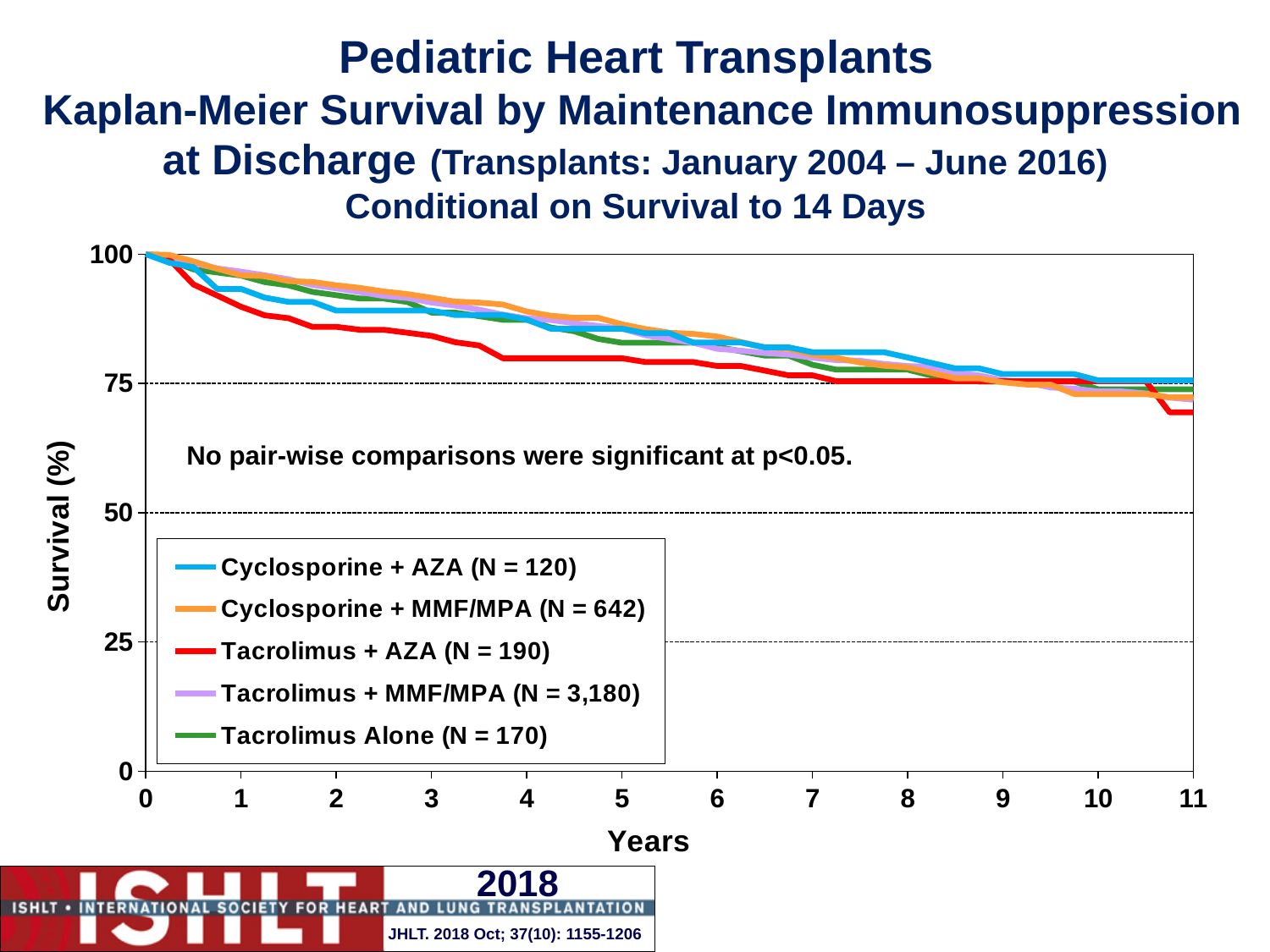
Do the survival curves rise or fall as years increase along the x axis? Fall What is the label of the x axis? Years What is the label of the y axis? Survival (%) Which series has the lowest survival at 1 year? Tacrolimus + AZA Is the survival for Cyclosporine + MMF/MPA at 2 years greater or less than 75? greater Is the survival for Tacrolimus + AZA at 4 years greater or less than 75? greater What kind of chart is shown on the slide? Line chart At 3 years, which has higher survival: Cyclosporine + MMF/MPA or Tacrolimus + AZA? Cyclosporine + MMF/MPA Is the survival for Tacrolimus + AZA at 11 years greater or less than 75? less How many series does the legend list? 5 How many x-axis tick marks (years) are labelled from 0 to 11? 12 Which series has the lowest survival at 11 years? Tacrolimus + AZA